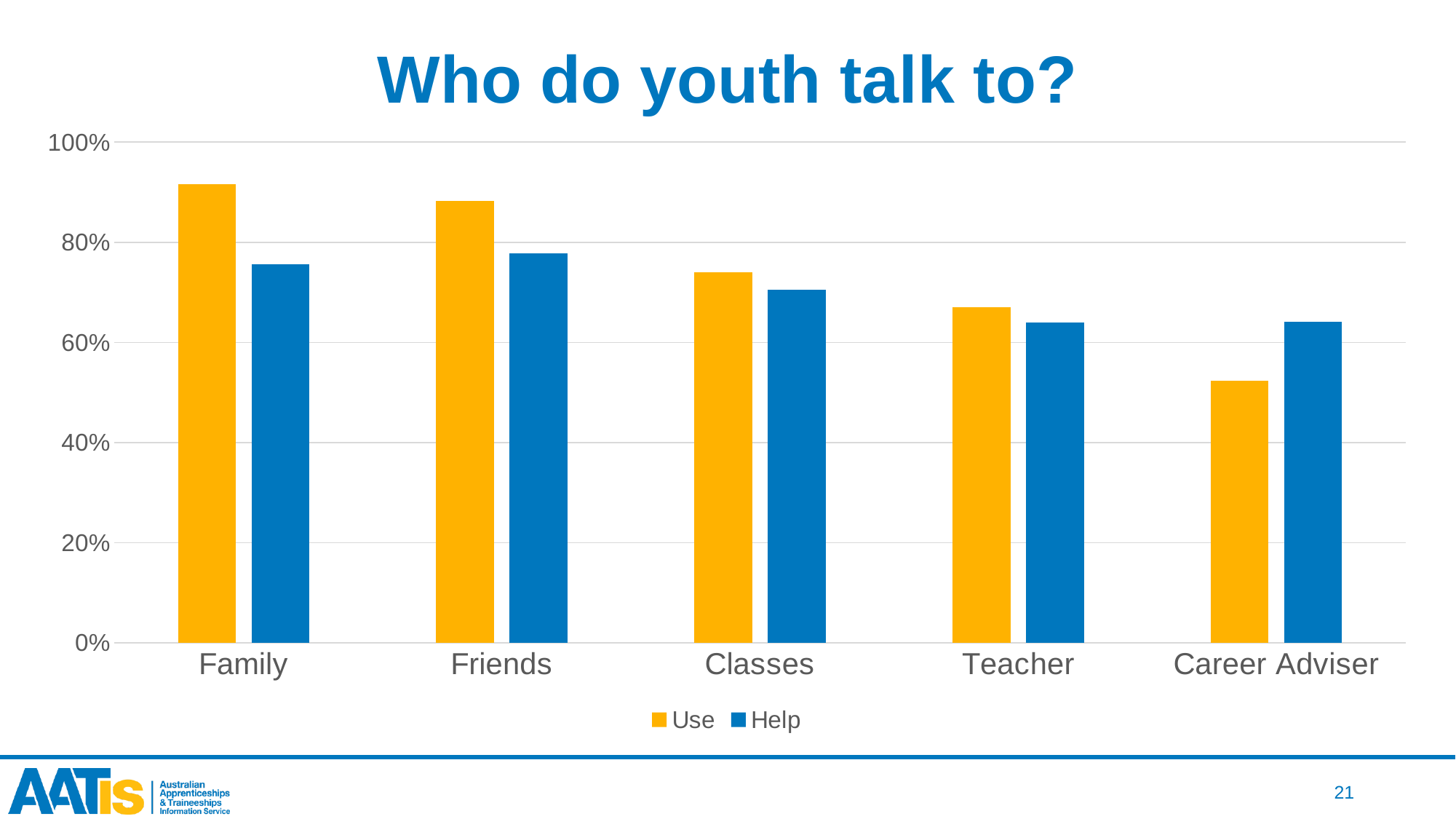
How many categories are shown on the x axis? 5 Which category has the highest value for the Use series? Family Which category has the lowest value for the Use series? Career Adviser How many series does the legend list? 2 What kind of chart is shown on the slide? bar chart For Family, which is larger, the Use value or the Help value? Use For Career Adviser, which is larger, the Use value or the Help value? Help Is the Use value for Family greater or less than 80%? greater What is the title of the chart? Who do youth talk to? Is the Help value for Classes greater or less than 80%? less Do the Use values rise or fall from Family to Career Adviser along the x axis? fall Is the Use value for Career Adviser greater or less than 60%? less